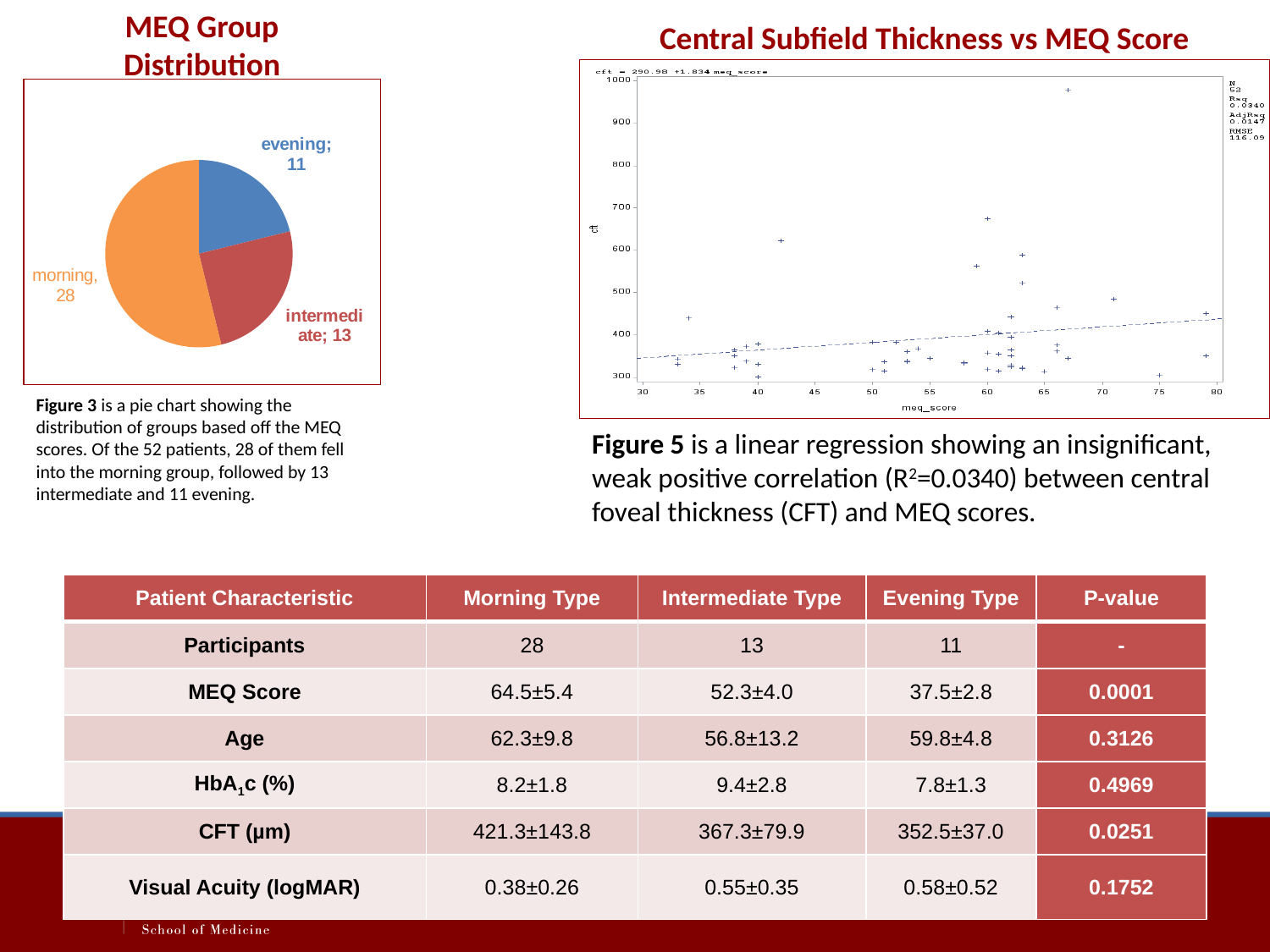
In the MEQ Group Distribution pie chart, how many patients are in the intermediate group? 13 In the MEQ Group Distribution pie chart, which group is larger, intermediate or evening? intermediate In the MEQ Group Distribution pie chart, which group has the largest slice? morning In the MEQ Group Distribution pie chart, how many patients are in the evening group? 11 What kind of chart is the Central Subfield Thickness vs MEQ Score chart? scatter plot In the Central Subfield Thickness vs MEQ Score chart, does the fitted regression line rise or fall as meq_score increases? rise In the Central Subfield Thickness vs MEQ Score chart, what is the label on the x axis? meq_score In the MEQ Group Distribution pie chart, how many more patients are in the morning group than in the evening group? 17 What kind of chart is the MEQ Group Distribution chart? pie chart In the MEQ Group Distribution pie chart, how many patients are in the morning group? 28 How many slices does the MEQ Group Distribution pie chart have? 3 In the MEQ Group Distribution pie chart, which group has the smallest slice? evening